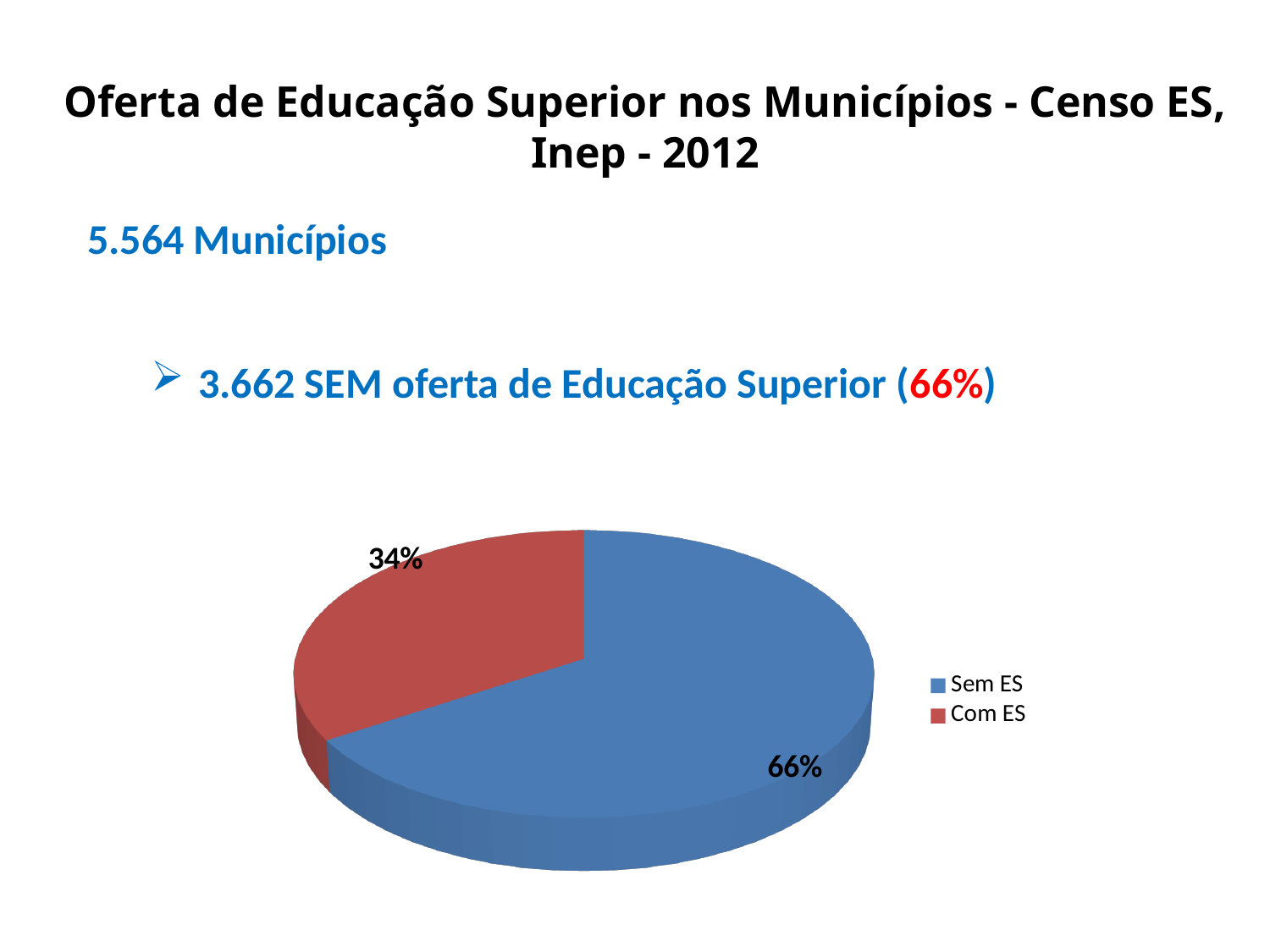
How many slices does the pie chart have? 2 What colour is the "Sem ES" slice? blue What share of the pie does the "Sem ES" slice represent? 66% What is the difference in percentage points between the "Sem ES" and "Com ES" slices? 32 Which slice of the pie is the smallest? Com ES What share of the pie does the "Com ES" slice represent? 34% What colour is the "Com ES" slice? red How many entries does the legend list? 2 What kind of chart is shown on the slide? pie chart Which is larger, the "Sem ES" slice or the "Com ES" slice? Sem ES Which slice of the pie is the largest? Sem ES